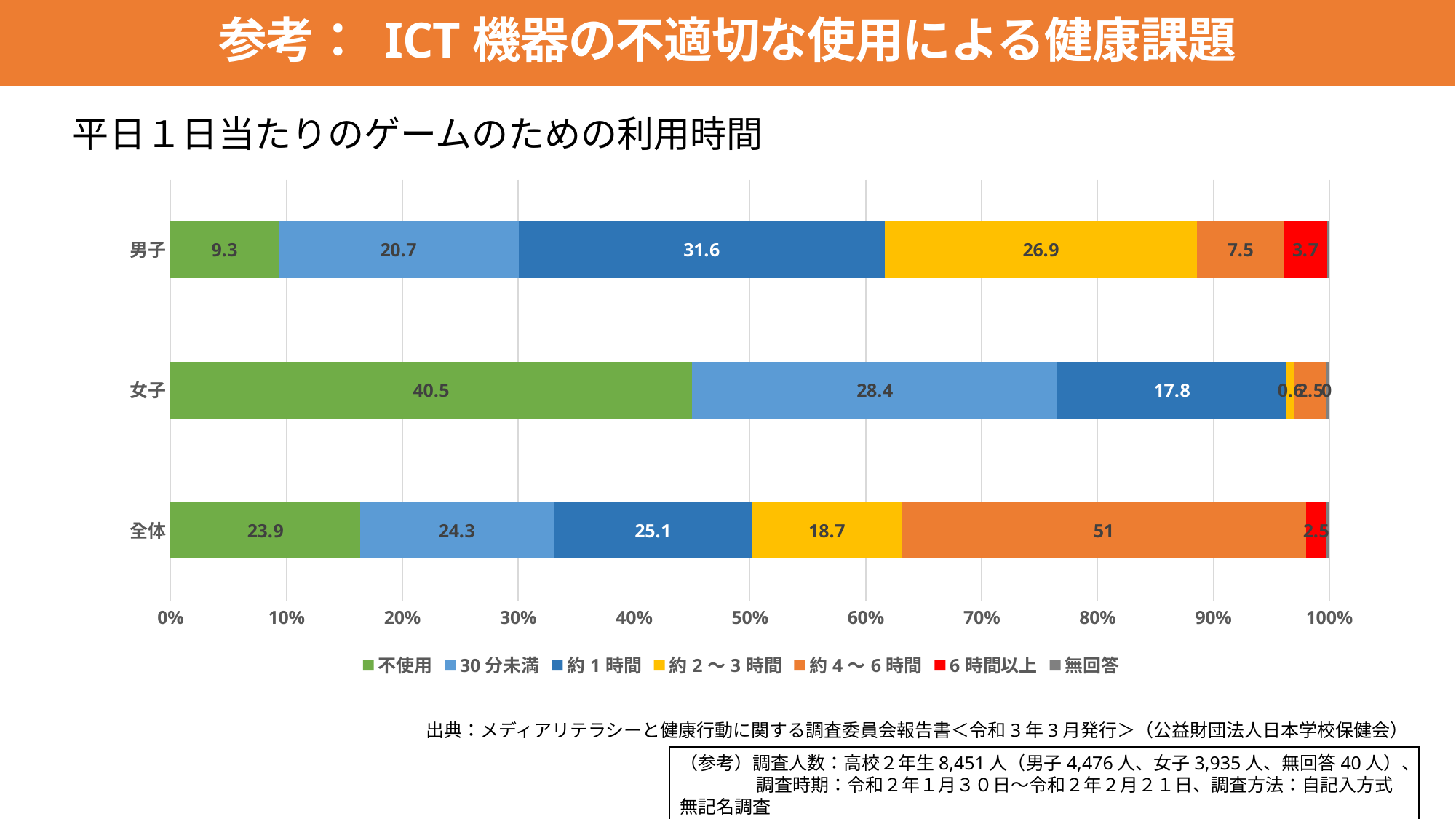
What is the value of 不使用 for 女子? 40.5 Which is larger, the 30分未満 value for 女子 or for 全体? 女子 Which series has the largest value in the 男子 bar? 約１時間 What is the difference between the 不使用 values for 女子 and 男子? 31.2 What is the title of the chart? 平日１日当たりのゲームのための利用時間 What is the value of 約４～６時間 for 全体? 51 How many categories (bars) are plotted on the chart? 3 How many series does the legend list? 7 What is the value of 約１時間 for 男子? 31.6 What kind of chart is shown on the slide? stacked bar chart What is the value of 6時間以上 for 男子? 3.7 Which series has the smallest printed value in the 男子 bar? 6時間以上